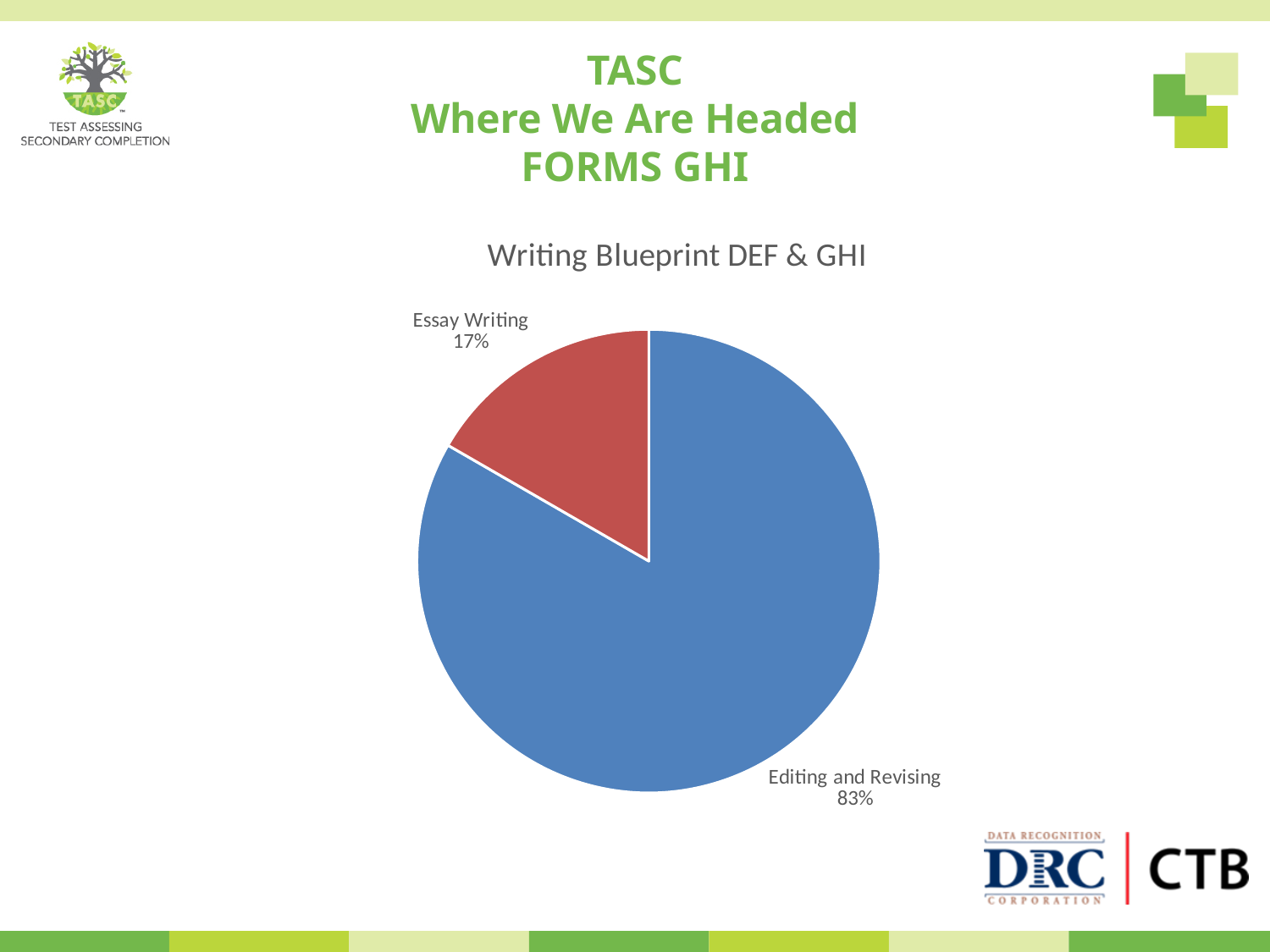
What is the difference in percentage points between Editing and Revising and Essay Writing? 66 What share of the pie is Essay Writing? 17% Which is larger, the share for Essay Writing or the share for Editing and Revising? Editing and Revising What is the title of the chart? Writing Blueprint DEF & GHI What colour is the Essay Writing slice? red Which category has the smallest share of the pie? Essay Writing What share of the pie is Editing and Revising? 83% What kind of chart is shown on the slide? pie chart Is the share for Editing and Revising greater or less than 50%? greater Which category has the largest share of the pie? Editing and Revising How many slices does the pie chart have? 2